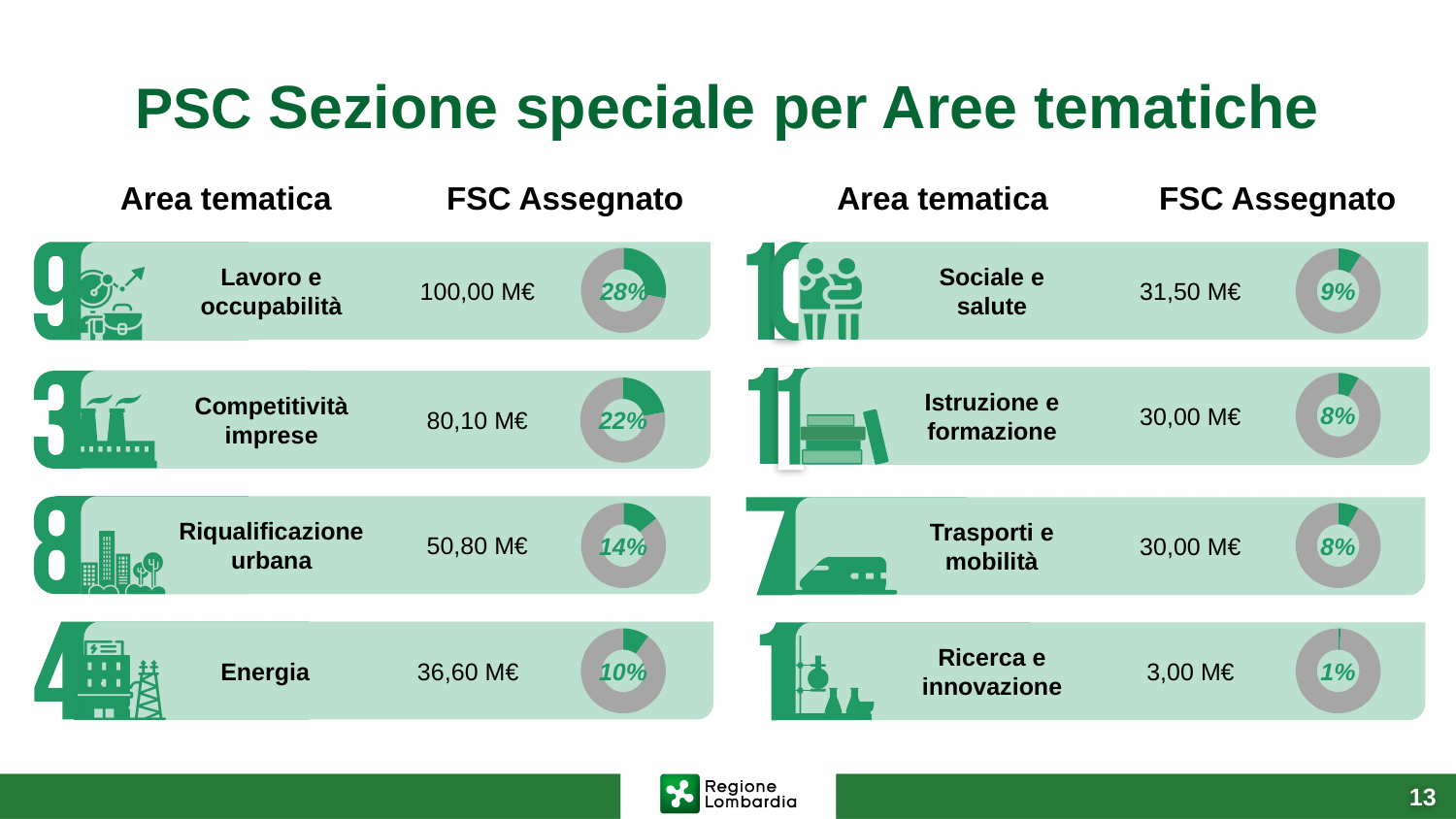
What percentage is shown in the donut chart for Competitività imprese? 22% What is the difference between the percentage in the Lavoro e occupabilità donut chart and the percentage in the Competitività imprese donut chart? 6% What kind of chart is used to show the percentage for each thematic area? Donut chart What colour is the filled portion of the donut charts? Green What percentage is shown in the donut chart for Ricerca e innovazione? 1% Which donut chart shows a larger percentage: Riqualificazione urbana or Energia? Riqualificazione urbana Which thematic area's donut chart shows the lowest percentage? Ricerca e innovazione Which thematic area's donut chart shows the highest percentage? Lavoro e occupabilità What percentage is shown in the donut chart for Sociale e salute? 9% What percentage is shown in the donut chart for Lavoro e occupabilità? 28% What percentage is shown in the donut chart for Trasporti e mobilità? 8% How many donut charts are shown on the slide? 8